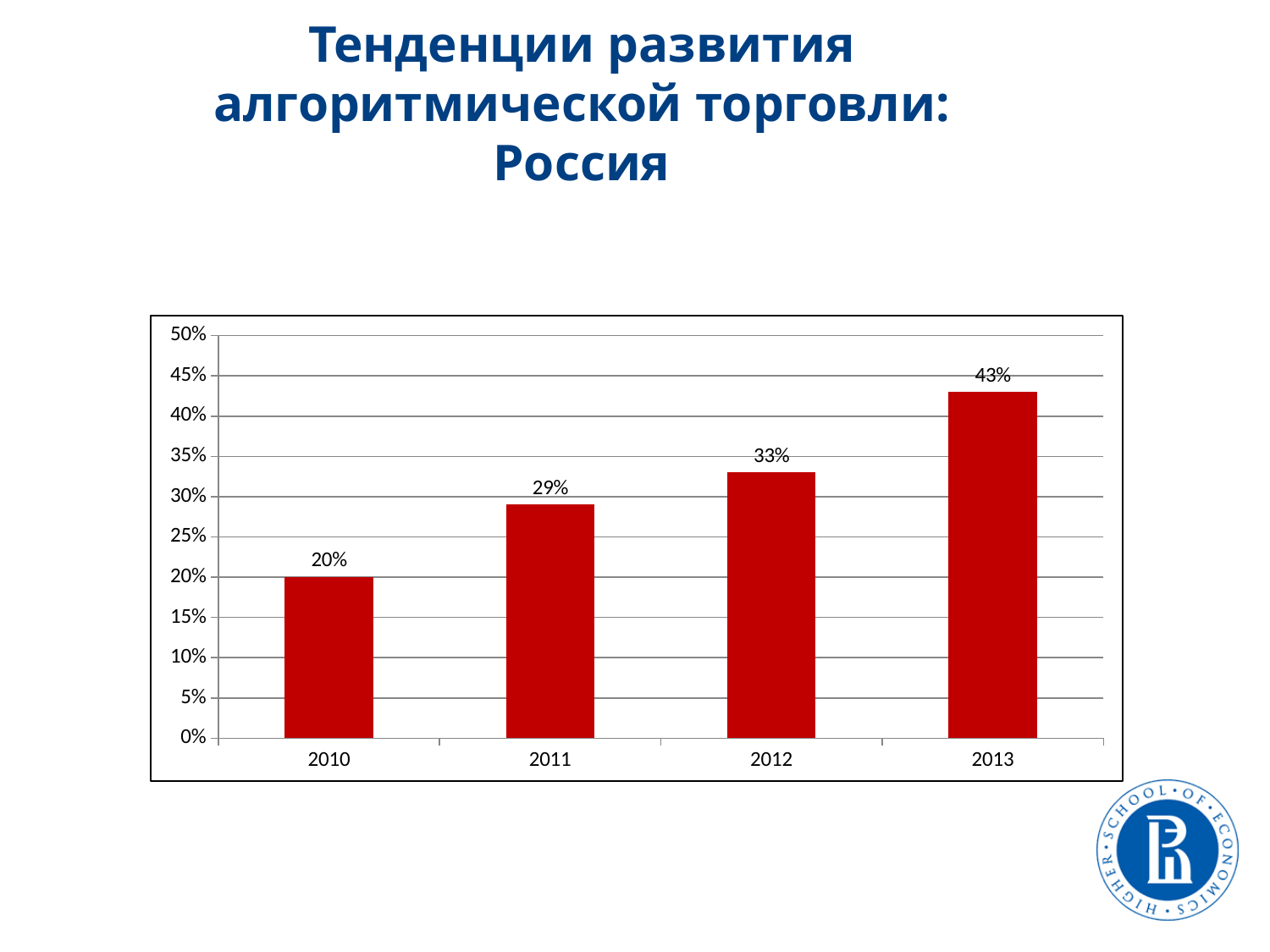
What is the value for 2010? 20% Do the values rise or fall from 2010 to 2013? rise Which year has the lowest value? 2010 What is the difference between the values for 2013 and 2010? 23% Which is larger, the value for 2011 or the value for 2012? 2012 What is the value for 2013? 43% Which year has the highest value? 2013 What is the difference between the values for 2012 and 2011? 4% What is the value for 2012? 33% How many years are shown on the x axis? 4 Is the value for 2013 greater or less than 40%? greater What kind of chart is shown on the slide? bar chart